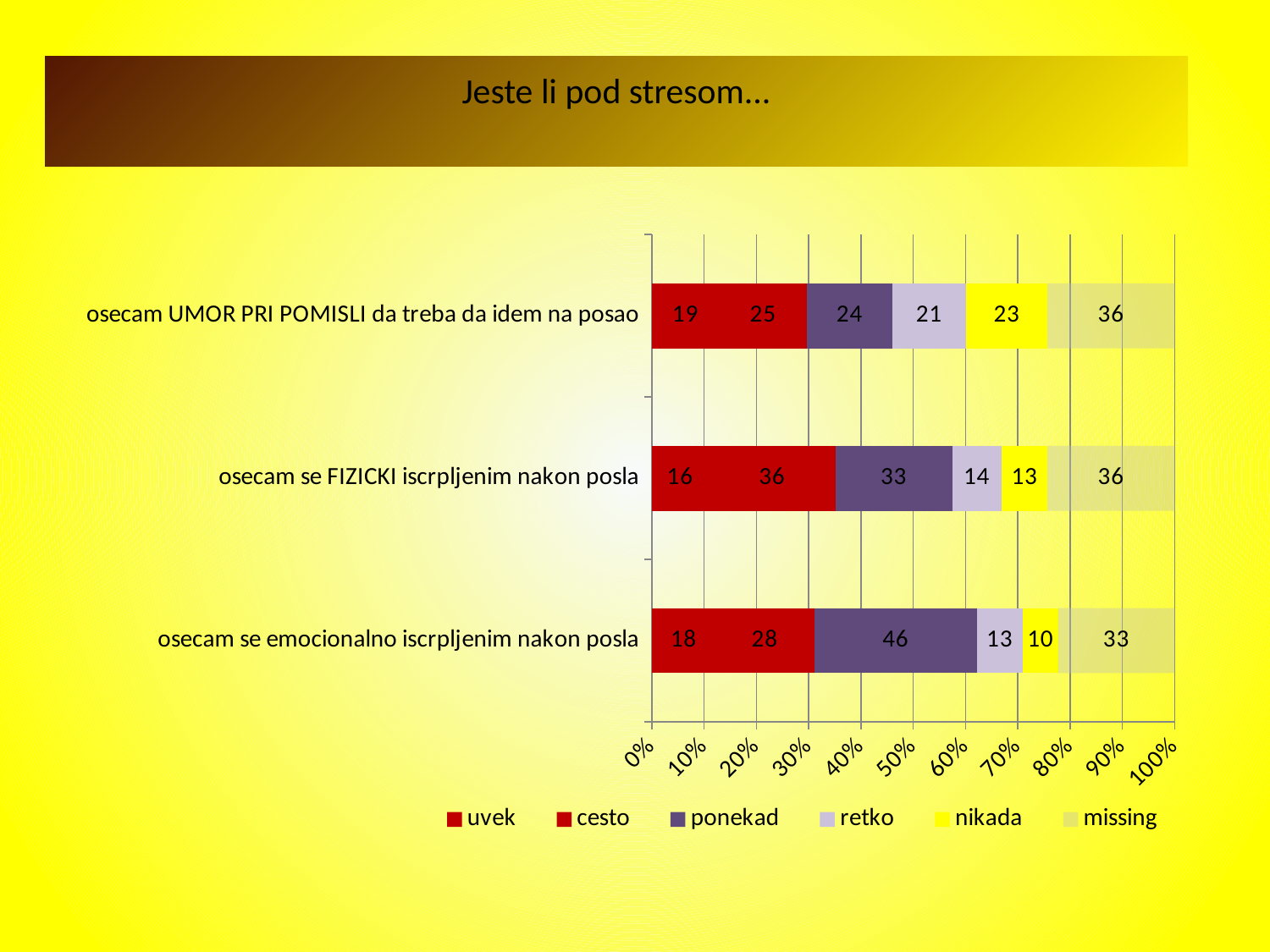
What is the value of 'ponekad' for 'osecam se emocionalno iscrpljenim nakon posla'? 46 What is the total of all segments in the bar for 'osecam se emocionalno iscrpljenim nakon posla'? 148 What kind of chart is shown on the slide? Stacked bar chart What is the title of the slide? Jeste li pod stresom… How many series does the legend list? 6 What is the difference between the 'nikada' values for 'osecam UMOR PRI POMISLI da treba da idem na posao' and 'osecam se emocionalno iscrpljenim nakon posla'? 13 Which category has the highest value for 'ponekad'? osecam se emocionalno iscrpljenim nakon posla How many categories (bars) does the chart show? 3 What is the value of 'cesto' for 'osecam se FIZICKI iscrpljenim nakon posla'? 36 Which category has the larger 'retko' value: 'osecam UMOR PRI POMISLI da treba da idem na posao' or 'osecam se FIZICKI iscrpljenim nakon posla'? osecam UMOR PRI POMISLI da treba da idem na posao What is the value of 'missing' for 'osecam UMOR PRI POMISLI da treba da idem na posao'? 36 What is the value of 'nikada' for 'osecam se FIZICKI iscrpljenim nakon posla'? 13